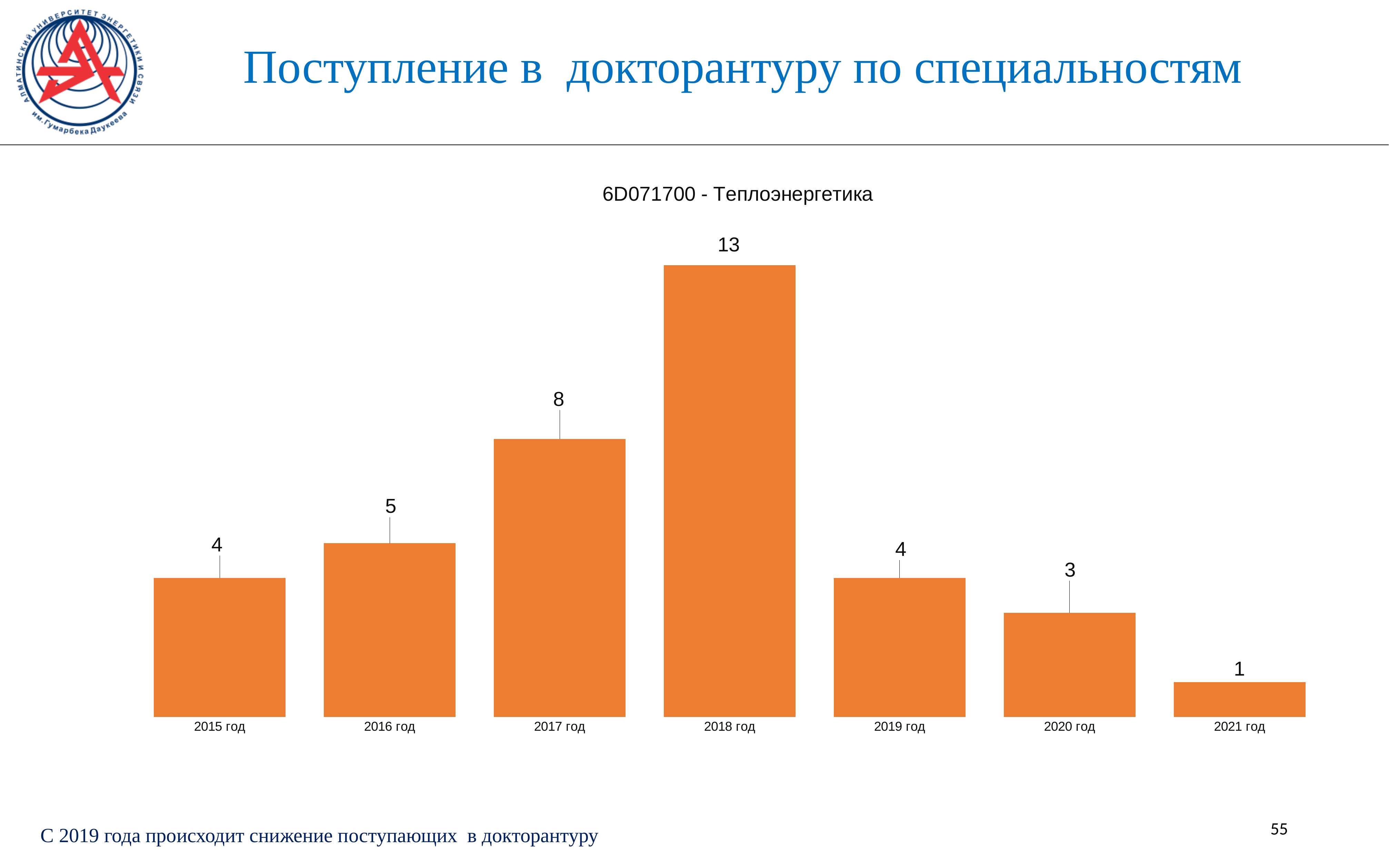
What is the difference between the values for 2018 год and 2017 год? 5 What is the title of the chart? 6D071700 - Теплоэнергетика Which is larger, the value for 2017 год or the value for 2019 год? 2017 год What is the value for 2016 год? 5 Which year has the lowest value? 2021 год What is the value for 2021 год? 1 Which year has the highest value? 2018 год What kind of chart is shown on the slide? bar chart How many years are shown on the x axis? 7 What is the difference between the values for 2016 год and 2020 год? 2 What is the value for 2018 год? 13 Do the values rise or fall from 2018 год to 2021 год? fall